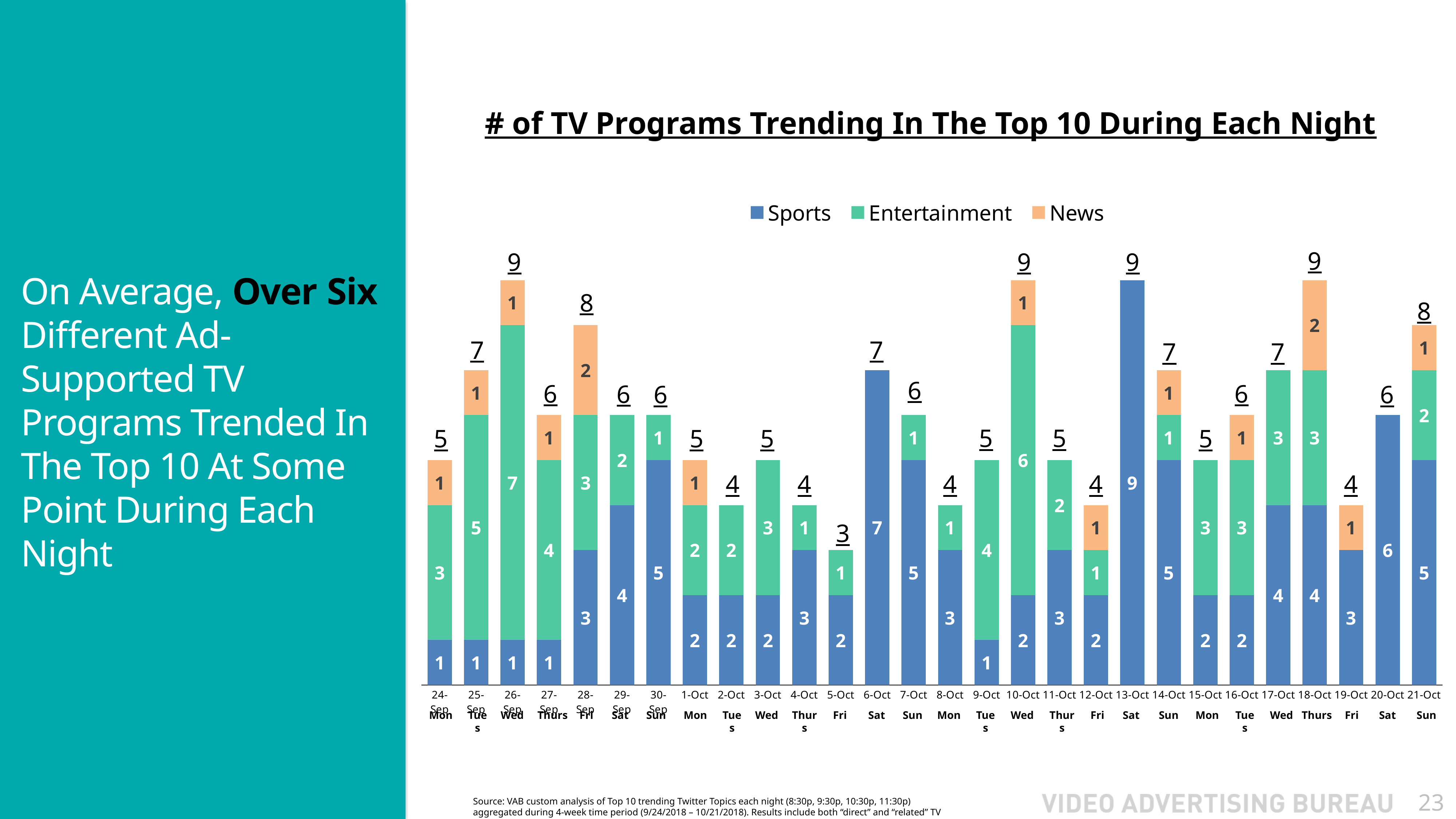
What is the total number of TV programs trending on 28-Sep (Fri)? 8 How many series does the legend list? 3 How many nights (bars) are shown in the chart? 28 What type of chart is shown on the slide? Stacked bar chart What is the Entertainment value for 26-Sep (Wed)? 7 Which is larger, the Sports value for 6-Oct (Sat) or the Sports value for 20-Oct (Sat)? 6-Oct (Sat) What is the Sports value for 13-Oct (Sat)? 9 Which series is shown in orange in the chart? News What is the title of the chart? # of TV Programs Trending In The Top 10 During Each Night Which night has the lowest total number of TV programs trending in the top 10? 5-Oct (Fri) What is the difference between the total for 10-Oct (Wed) and the total for 9-Oct (Tues)? 4 What is the News value for 18-Oct (Thurs)? 2